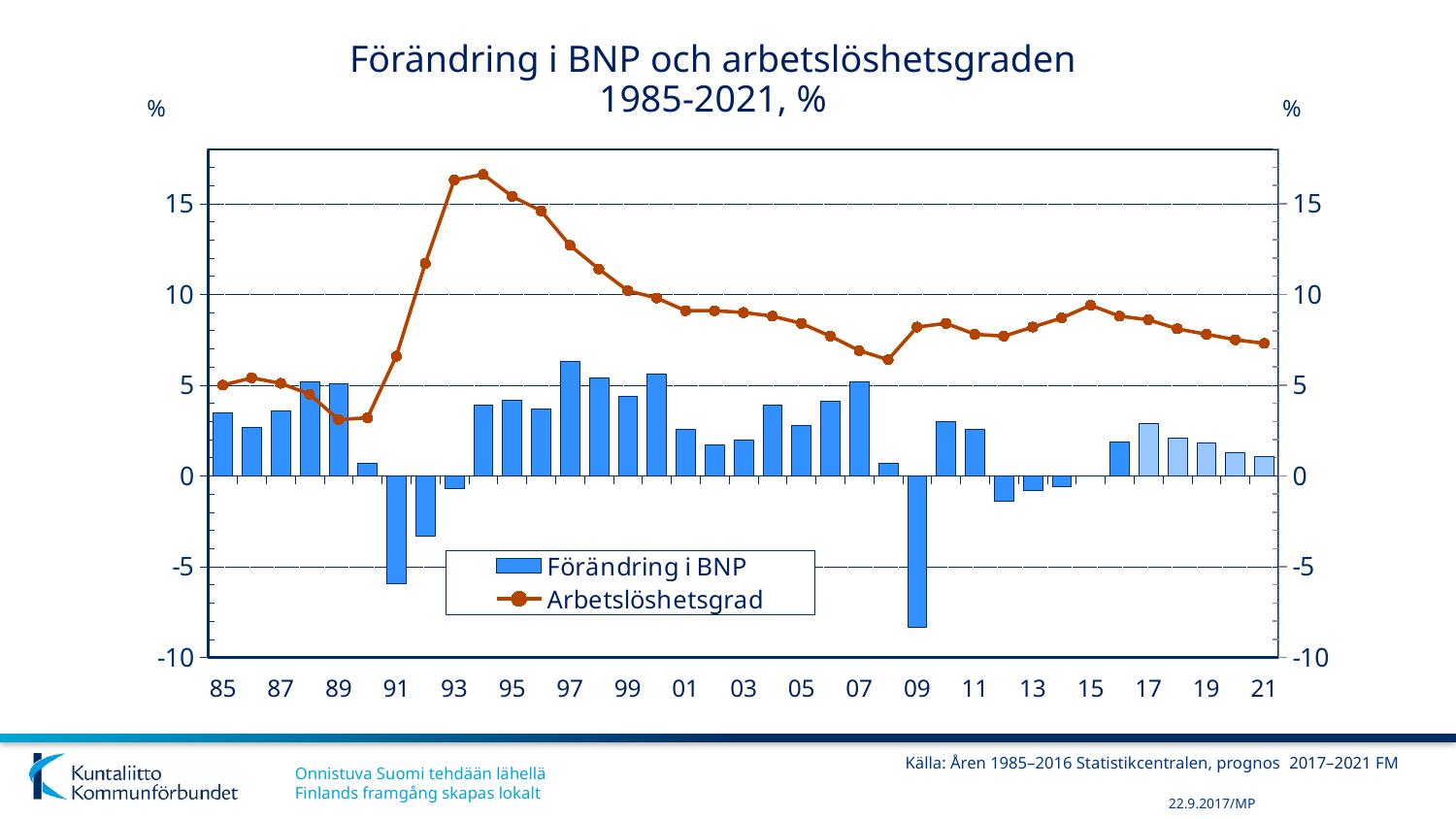
What kind of chart is shown on the slide? A combined bar and line chart Is the Förändring i BNP value for 2009 greater or less than -5? less In which year is the Förändring i BNP bar the highest? 1997 Which series is drawn as bars? Förändring i BNP In which year is the Förändring i BNP bar the lowest? 2009 Is the Arbetslöshetsgrad value for 2008 greater or less than 10? less Is the Arbetslöshetsgrad value for 1994 greater or less than 15? greater How many series does the legend list? 2 What are the two series named in the legend? Förändring i BNP and Arbetslöshetsgrad Which year has the lower Förändring i BNP value, 1991 or 2009? 2009 Which year has the higher Arbetslöshetsgrad value, 1994 or 2008? 1994 Does the Arbetslöshetsgrad line rise or fall from 1994 to 2008? fall